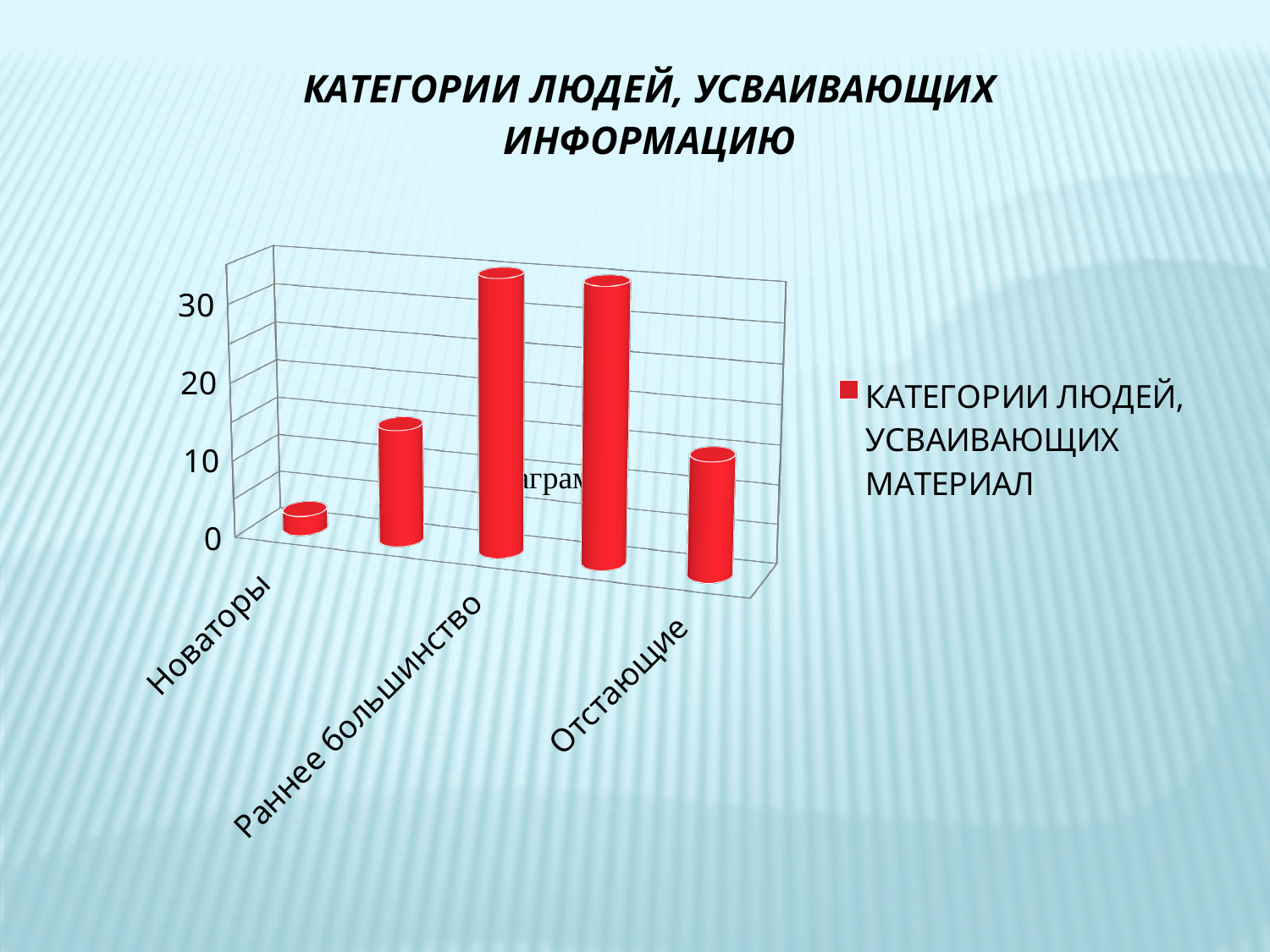
Is the value for Отстающие greater or less than 10? greater What colour are the bars in the chart? red How many bars does the chart contain? 5 Is the value for Новаторы greater or less than 10? less What kind of chart is shown on the slide? bar chart What series name is shown in the chart legend? КАТЕГОРИИ ЛЮДЕЙ, УСВАИВАЮЩИХ МАТЕРИАЛ Which is larger, the value for Новаторы or the value for Отстающие? Отстающие Is the value for Раннее большинство greater or less than 20? greater Which category has the lowest value in the chart? Новаторы How many series does the legend list? 1